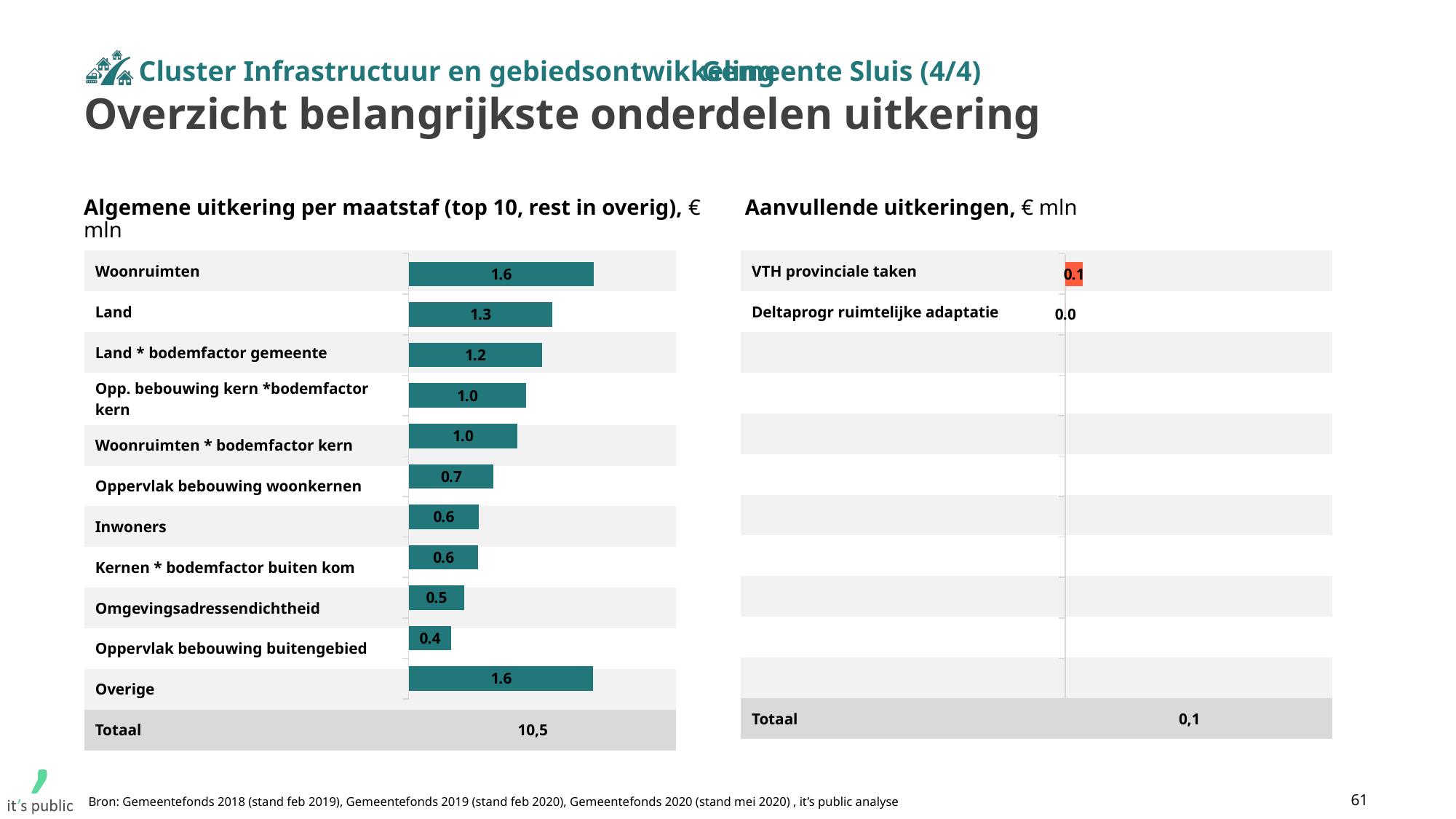
What is the Totaal shown below the chart 'Aanvullende uitkeringen'? 0,1 In the chart 'Aanvullende uitkeringen', what is the value for VTH provinciale taken? 0.1 In the chart 'Algemene uitkering per maatstaf', what is the value for Woonruimten? 1.6 In the chart 'Algemene uitkering per maatstaf', what is the difference between Land and Inwoners? 0.7 What is the Totaal shown below the chart 'Algemene uitkering per maatstaf'? 10,5 What kind of chart is 'Algemene uitkering per maatstaf'? Bar chart In the chart 'Aanvullende uitkeringen', what is the value for Deltaprogr ruimtelijke adaptatie? 0.0 In the chart 'Algemene uitkering per maatstaf', what is the value for Omgevingsadressendichtheid? 0.5 In the chart 'Algemene uitkering per maatstaf', what is the value for Land * bodemfactor gemeente? 1.2 How many categories (bars) are shown in the chart 'Algemene uitkering per maatstaf'? 11 In the chart 'Algemene uitkering per maatstaf', which category has the lowest value? Oppervlak bebouwing buitengebied In the chart 'Algemene uitkering per maatstaf', which is larger: Oppervlak bebouwing woonkernen or Kernen * bodemfactor buiten kom? Oppervlak bebouwing woonkernen